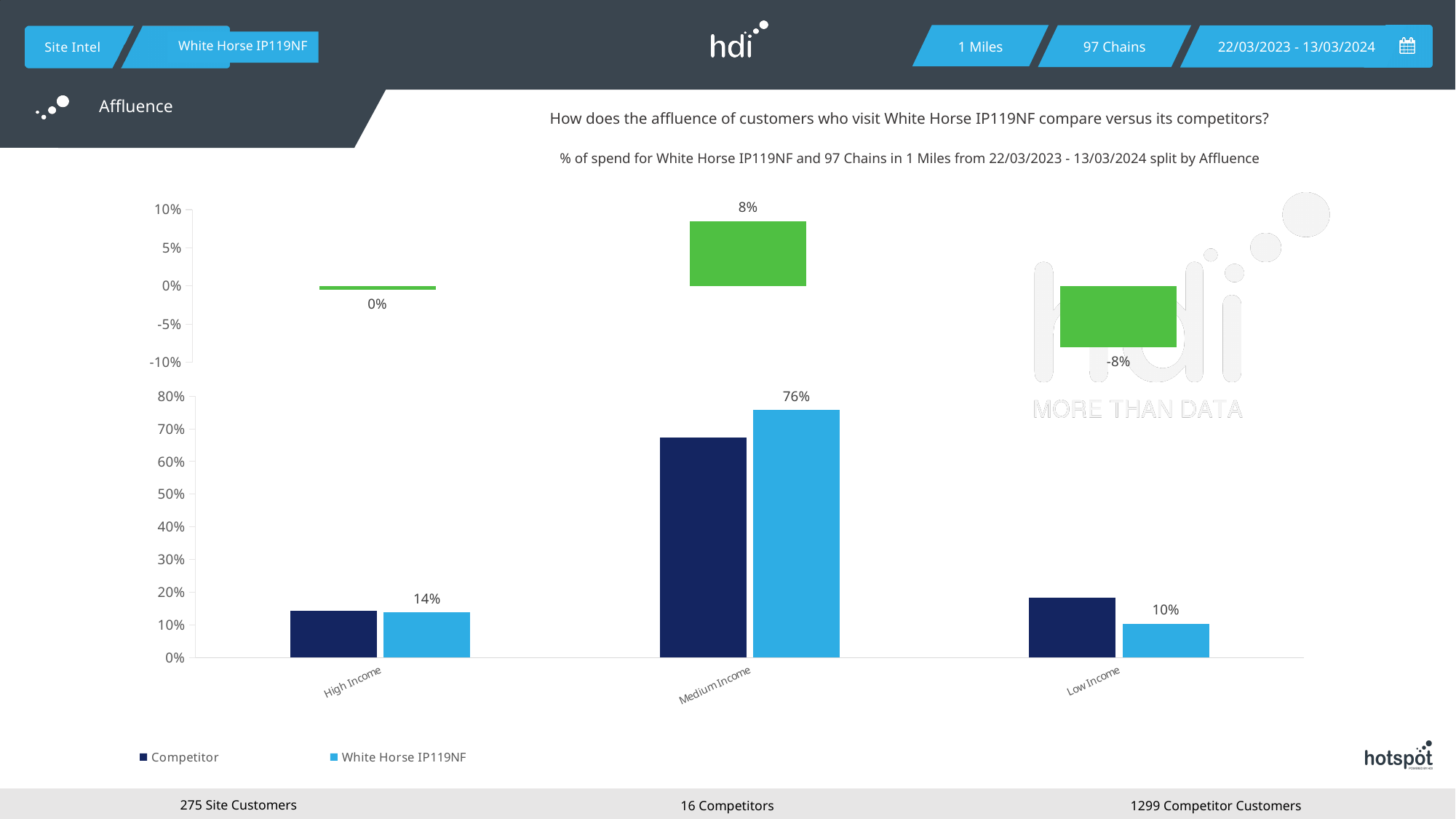
In the bottom bar chart, which category has the lowest value for White Horse IP119NF? Low Income In the top difference chart, what is the value shown for Low Income? -8% How many series does the legend of the bottom bar chart list? 2 In the bottom bar chart, what is the difference between the White Horse IP119NF values for Medium Income and High Income? 62% In the top difference chart, what is the value shown for Medium Income? 8% In the bottom bar chart, which category has the highest value for White Horse IP119NF? Medium Income In the bottom bar chart, what is the value for White Horse IP119NF in the Medium Income category? 76% In the bottom bar chart, which is larger for Low Income: the Competitor value or the White Horse IP119NF value? Competitor In the bottom bar chart, what is the value for White Horse IP119NF in the High Income category? 14% In the bottom bar chart, is the Competitor value for Medium Income greater or less than 60%? greater What type of chart is the bottom chart on the slide? Bar chart In the bottom bar chart, what is the value for White Horse IP119NF in the Low Income category? 10%